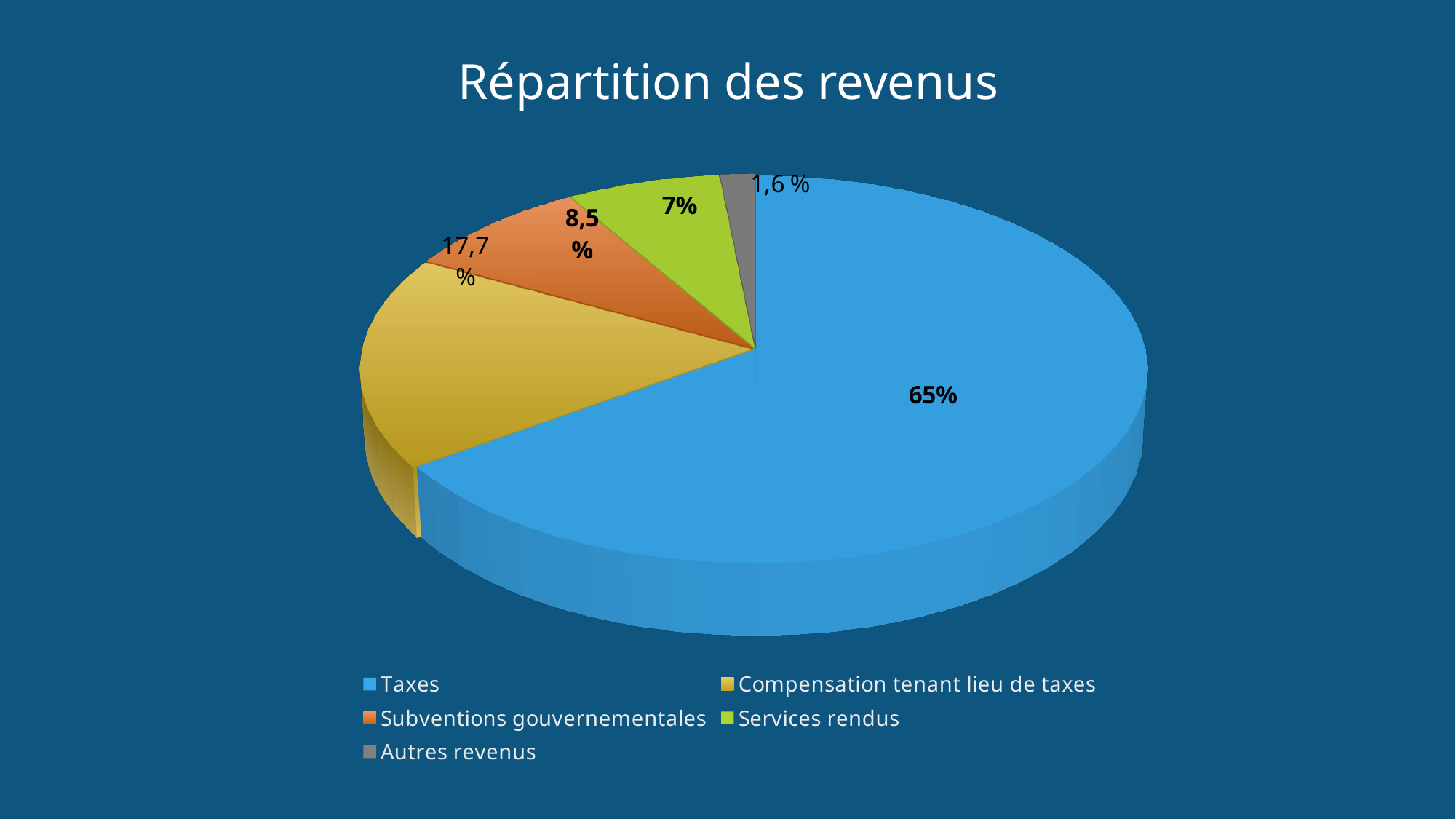
Which category has the smallest share of revenue? Autres revenus What share of revenue comes from Subventions gouvernementales? 8,5 % Which is larger: the share for Subventions gouvernementales or the share for Services rendus? Subventions gouvernementales What share of revenue comes from Autres revenus? 1,6 % What share of revenue comes from Compensation tenant lieu de taxes? 17,7 % What kind of chart is shown on the slide? Pie chart What share of revenue comes from Services rendus? 7% How many categories does the pie chart show? 5 What colour is the slice for Compensation tenant lieu de taxes? Yellow Which category has the largest share of revenue? Taxes What share of revenue comes from Taxes? 65% What is the title of the chart? Répartition des revenus